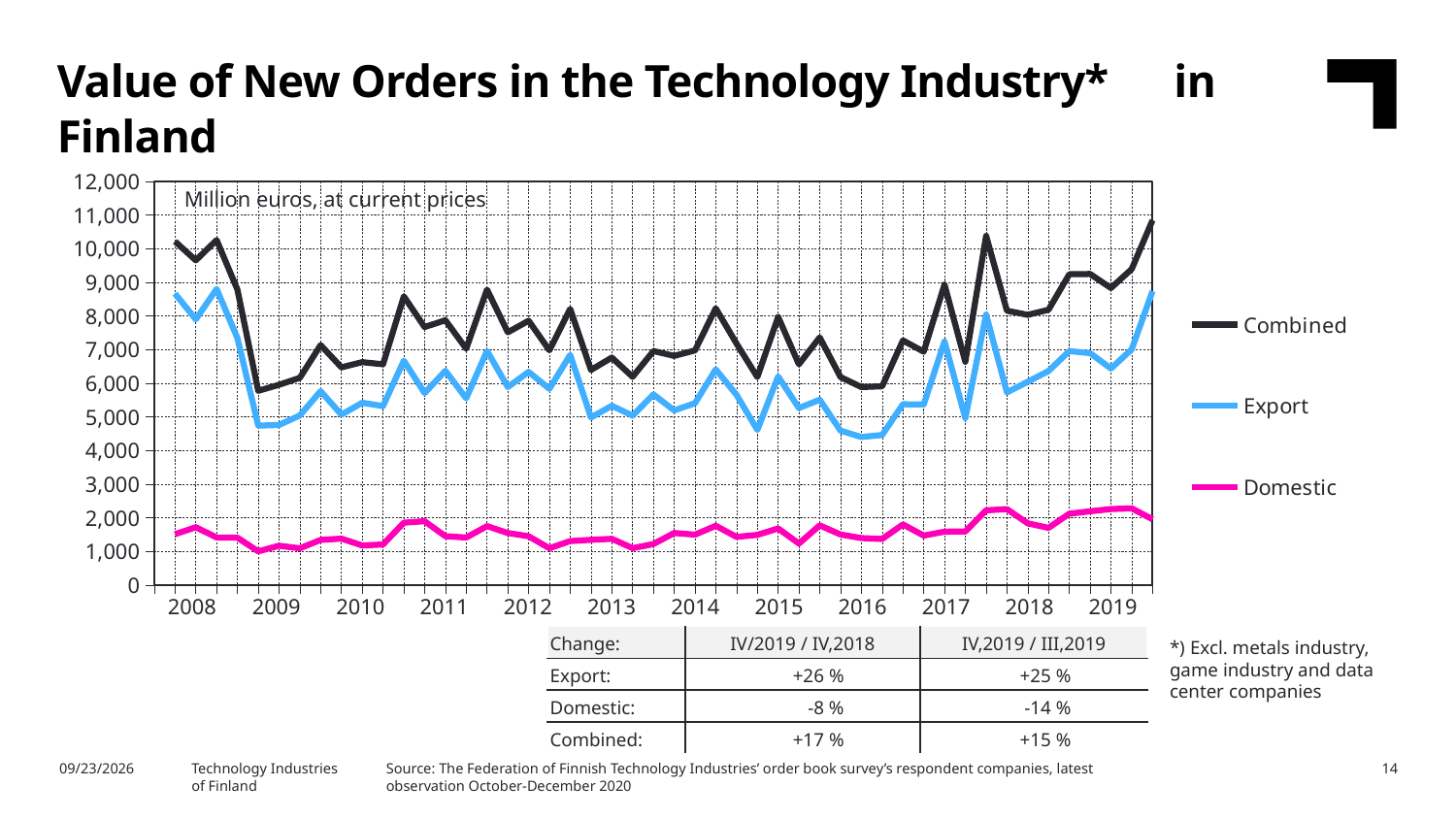
Which series has the lowest values throughout the chart? Domestic Does the Export series rise or fall from 2016 to the end of 2019? Rise How many series does the legend list? 3 Is the value for Combined at the end of 2019 greater or less than 10,000? greater What are the three series named in the legend? Combined, Export, Domestic Which series has the highest values throughout the chart? Combined What kind of chart is shown on the slide? Line chart At the end of 2019, which is larger, the Export value or the Domestic value? Export Is the value for Domestic at the end of 2019 greater or less than 3,000? less What unit note is printed inside the chart area? Million euros, at current prices Is the lowest value for Export in 2016 greater or less than 5,000? less How many years are labelled on the x axis? 12